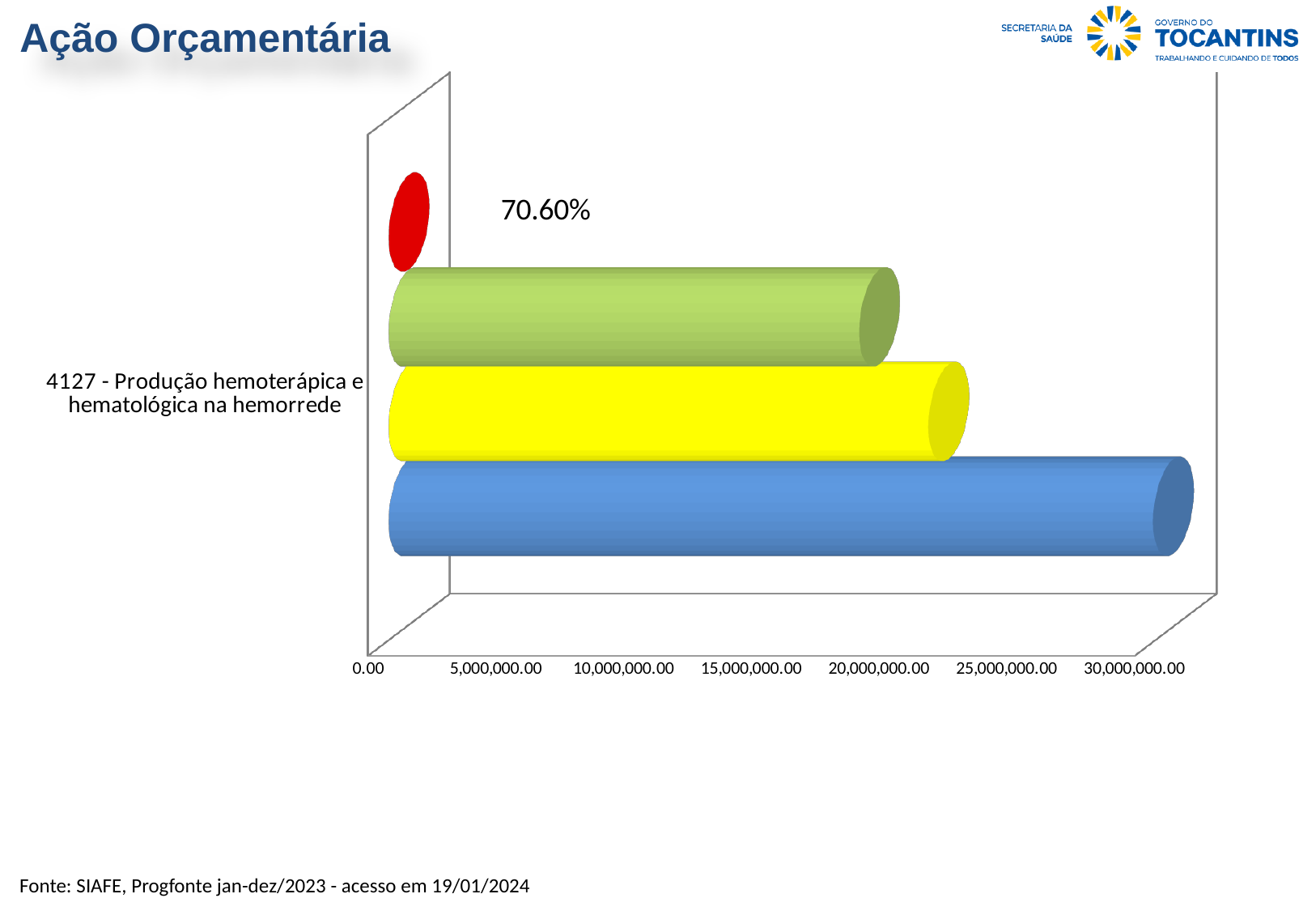
What percentage value is printed as a data label on the chart? 70.60% What is the name of the category plotted on the chart? 4127 - Produção hemoterápica e hematológica na hemorrede Is the value of the green bar greater or less than 10,000,000.00? greater How many categories are plotted on the chart? 1 Is the value of the blue bar greater or less than 25,000,000.00? greater Which coloured bar is the shortest on the chart? red Which is larger, the blue bar or the green bar? blue Which coloured bar is the longest on the chart? blue Is the value of the red bar greater or less than 5,000,000.00? less What is the highest tick value shown on the horizontal axis? 30,000,000.00 Which is larger, the yellow bar or the green bar? yellow What kind of chart is shown on the slide? bar chart